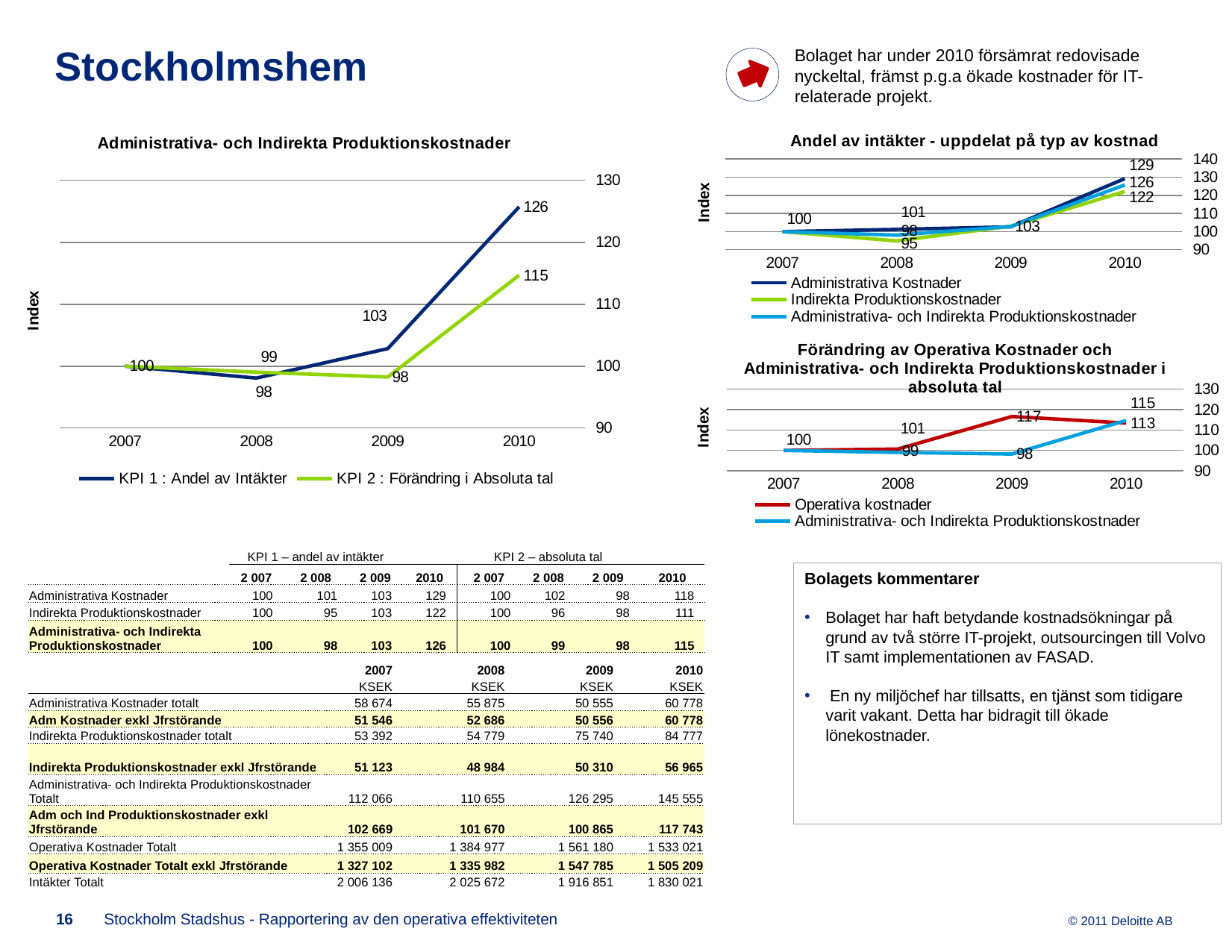
In the chart titled 'Andel av intäkter - uppdelat på typ av kostnad', how many series does the legend list? 3 In the chart titled 'Administrativa- och Indirekta Produktionskostnader', how many series does the legend list? 2 In the chart titled 'Administrativa- och Indirekta Produktionskostnader', what is the difference between KPI 1 and KPI 2 in 2010? 11 In the chart titled 'Andel av intäkter - uppdelat på typ av kostnad', what is the value of Administrativa Kostnader in 2010? 129 In the chart titled 'Förändring av Operativa Kostnader och Administrativa- och Indirekta Produktionskostnader i absoluta tal', which series is higher in 2010? Administrativa- och Indirekta Produktionskostnader In the chart titled 'Administrativa- och Indirekta Produktionskostnader', what is the value of KPI 1 : Andel av Intäkter in 2010? 126 In the chart titled 'Andel av intäkter - uppdelat på typ av kostnad', which series has the lowest value in 2008? Indirekta Produktionskostnader In the chart titled 'Förändring av Operativa Kostnader och Administrativa- och Indirekta Produktionskostnader i absoluta tal', how many years are shown on the x axis? 4 In the chart titled 'Administrativa- och Indirekta Produktionskostnader', in which year is KPI 1 : Andel av Intäkter lowest? 2008 In the chart titled 'Administrativa- och Indirekta Produktionskostnader', what is the value of KPI 2 : Förändring i Absoluta tal in 2010? 115 In the chart titled 'Förändring av Operativa Kostnader och Administrativa- och Indirekta Produktionskostnader i absoluta tal', what is the value of Operativa kostnader in 2009? 117 What kind of chart is 'Administrativa- och Indirekta Produktionskostnader'? Line chart